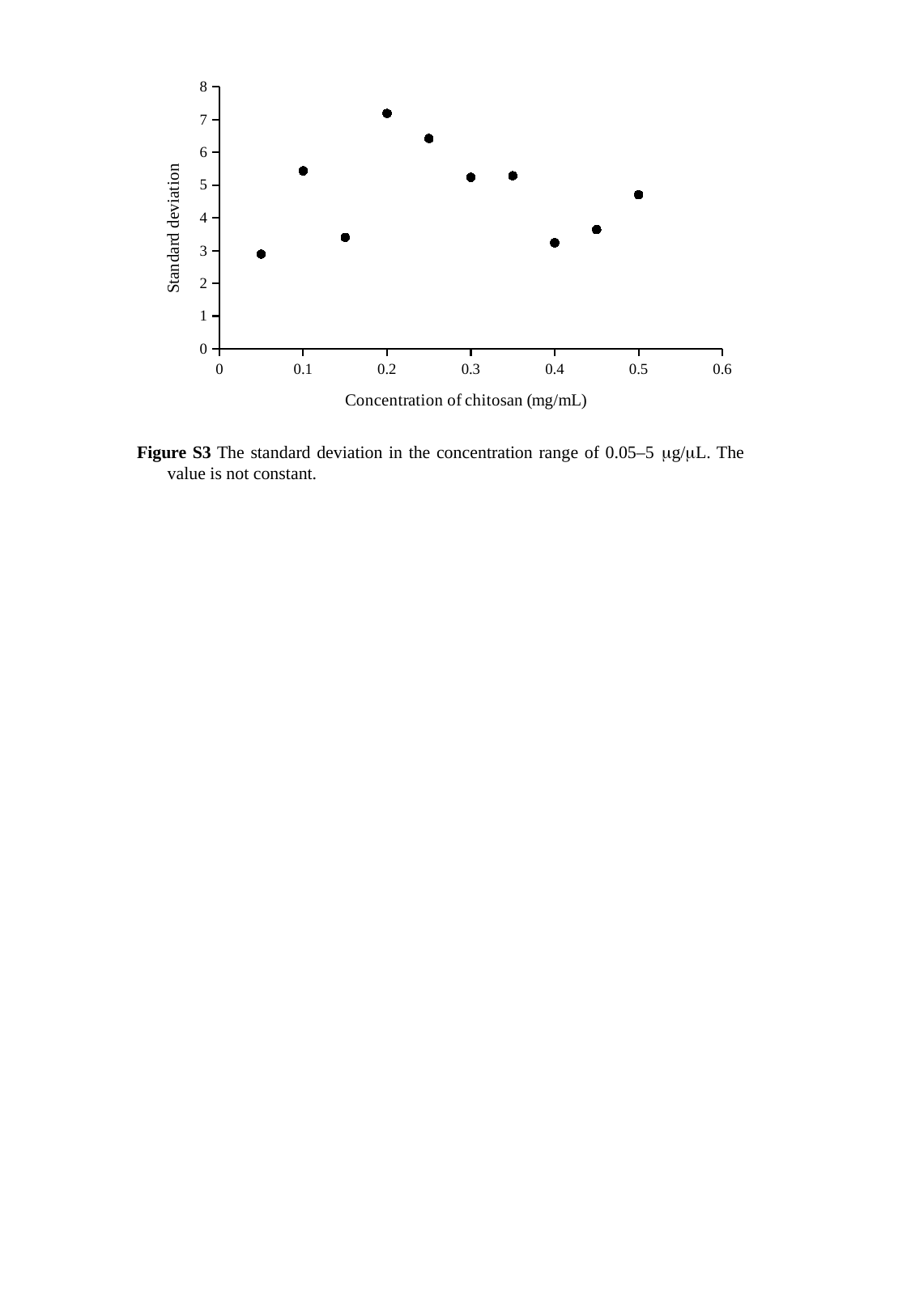
Is the standard deviation at a chitosan concentration of 0.15 mg/mL greater or less than 4? less Is the standard deviation at a chitosan concentration of 0.2 mg/mL greater or less than 7? greater Is the standard deviation at a chitosan concentration of 0.5 mg/mL greater or less than 5? less At which concentration of chitosan is the standard deviation highest? 0.2 Which has the larger standard deviation: the point at 0.1 mg/mL or the point at 0.15 mg/mL? 0.1 mg/mL What kind of chart is shown on the slide? scatter plot What is the label of the x axis? Concentration of chitosan (mg/mL) At which concentration of chitosan is the standard deviation lowest? 0.05 How many data points are plotted in the chart? 10 Which has the larger standard deviation: the point at 0.2 mg/mL or the point at 0.25 mg/mL? 0.2 mg/mL